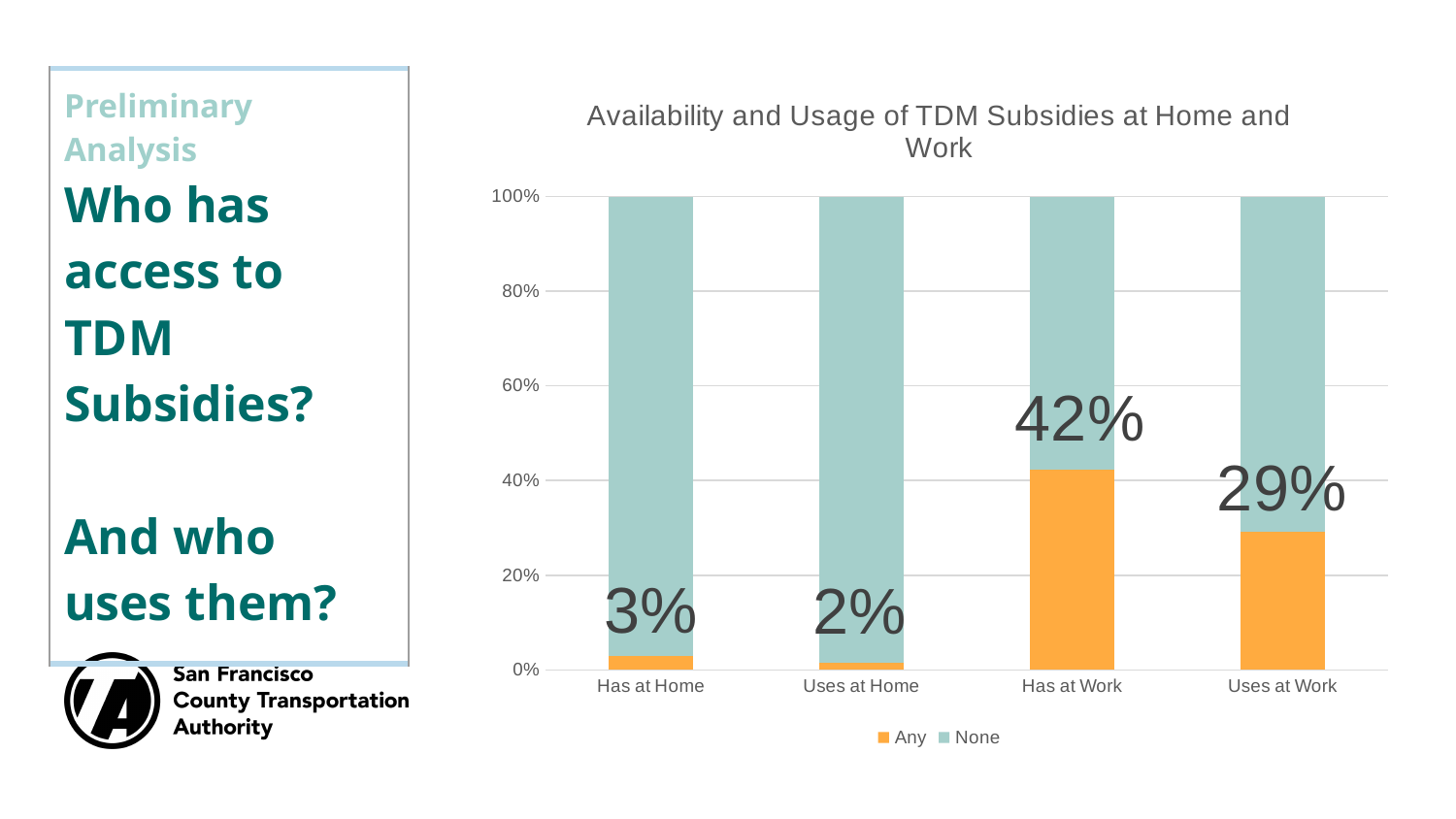
What is the value of the "Any" series for Has at Home? 3% What is the value of the "Any" series for Has at Work? 42% How many categories are shown on the x axis? 4 Which category has the lowest "Any" value? Uses at Home Which category has the highest "Any" value? Has at Work Which is larger, the "Any" value for Has at Home or for Uses at Home? Has at Home What is the difference between the "Any" values for Has at Work and Uses at Work? 13% What is the value of the "Any" series for Uses at Work? 29% Is the "Any" value for Has at Work greater or less than 40%? greater What is the value of the "Any" series for Uses at Home? 2% What kind of chart is shown on the slide? Stacked bar chart How many series does the legend list? 2